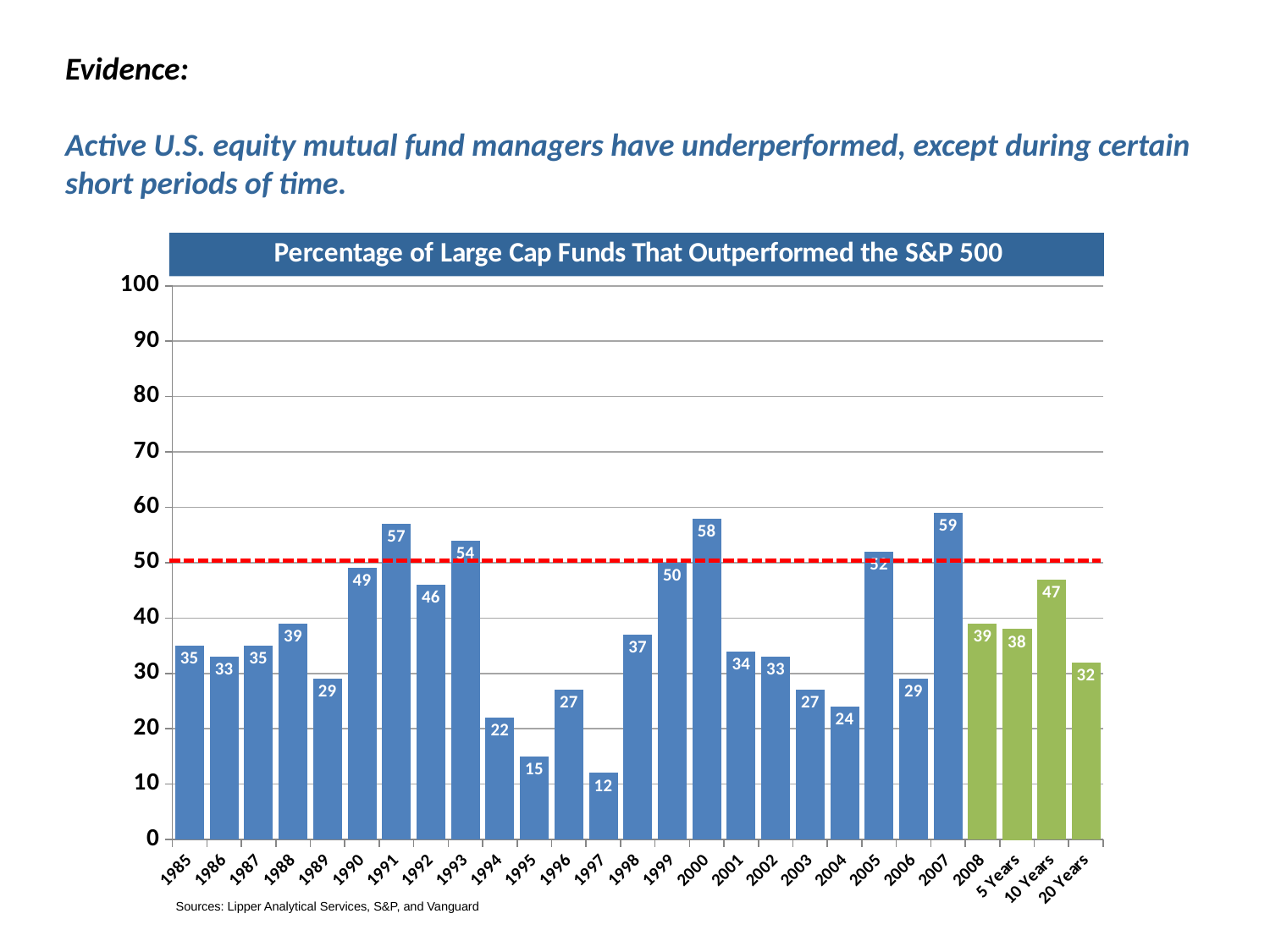
What is the value for 1997? 12 What is the title of the chart? Percentage of Large Cap Funds That Outperformed the S&P 500 What type of chart is shown on the slide? bar chart Which category has the highest value? 2007 Which is larger, the value for 1993 or the value for 1999? 1993 Which category has the lowest value? 1997 What is the difference between the values for 2007 and 2008? 20 At what value is the red dashed horizontal line drawn? 50 What is the value for 10 Years? 47 What is the difference between the values for 1991 and 1992? 11 What is the value for 2000? 58 How many categories are shown on the x axis? 27